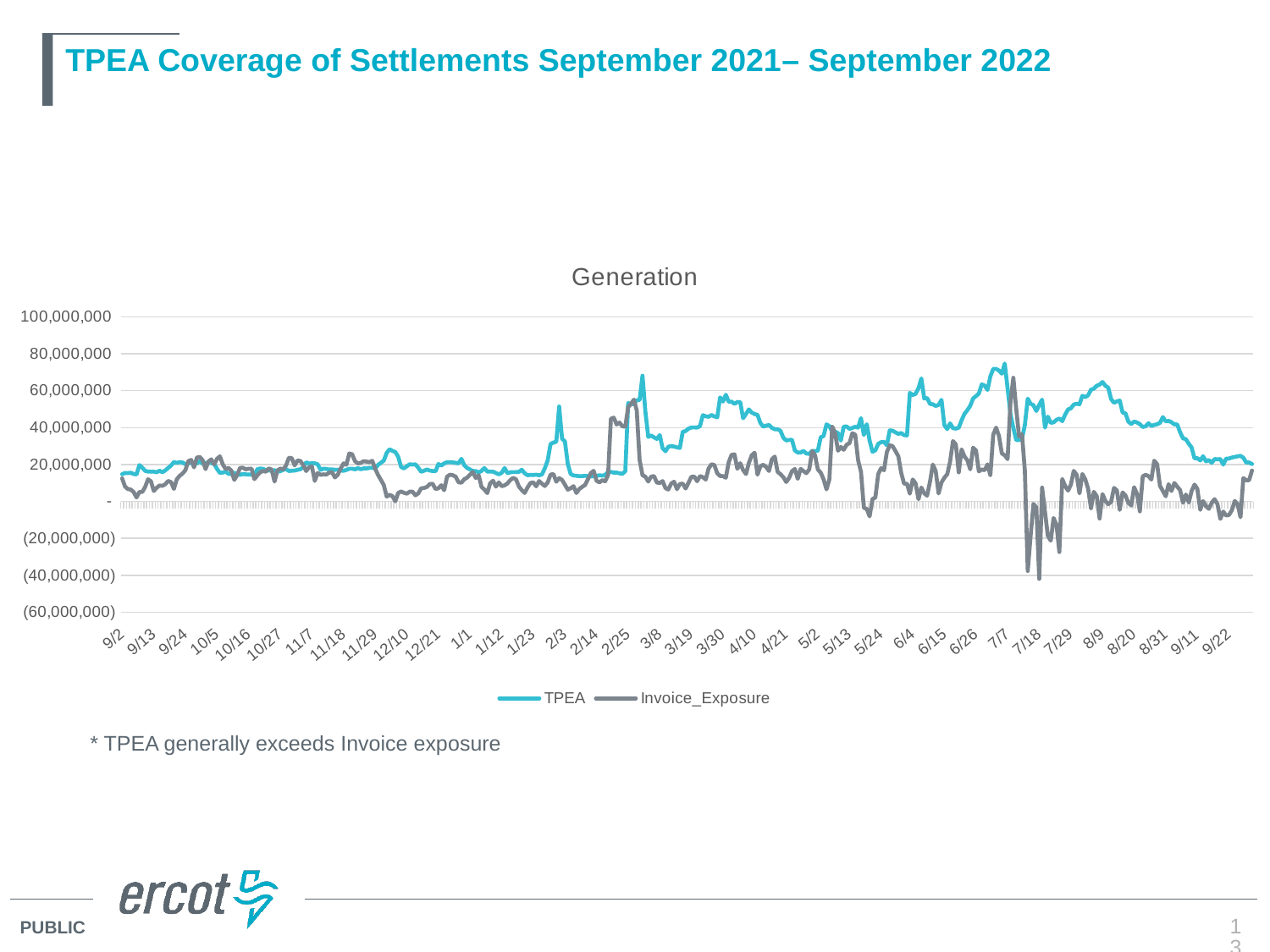
Around 2/3, which series has the larger value, TPEA or Invoice_Exposure? TPEA What are the two series named in the legend? TPEA and Invoice_Exposure Is the peak value of TPEA around 7/7 greater or less than 60,000,000? greater What is the title of the chart? Generation What kind of chart is shown on the slide? line chart How many series does the legend list? 2 Is the lowest value of Invoice_Exposure, around 7/18, greater or less than (20,000,000)? less Is the value of TPEA at 9/2 greater or less than 40,000,000? less What is the highest value shown on the y axis? 100,000,000 Which series drops below zero during July? Invoice_Exposure What is the last date label on the x axis? 9/22 What is the first date label on the x axis? 9/2